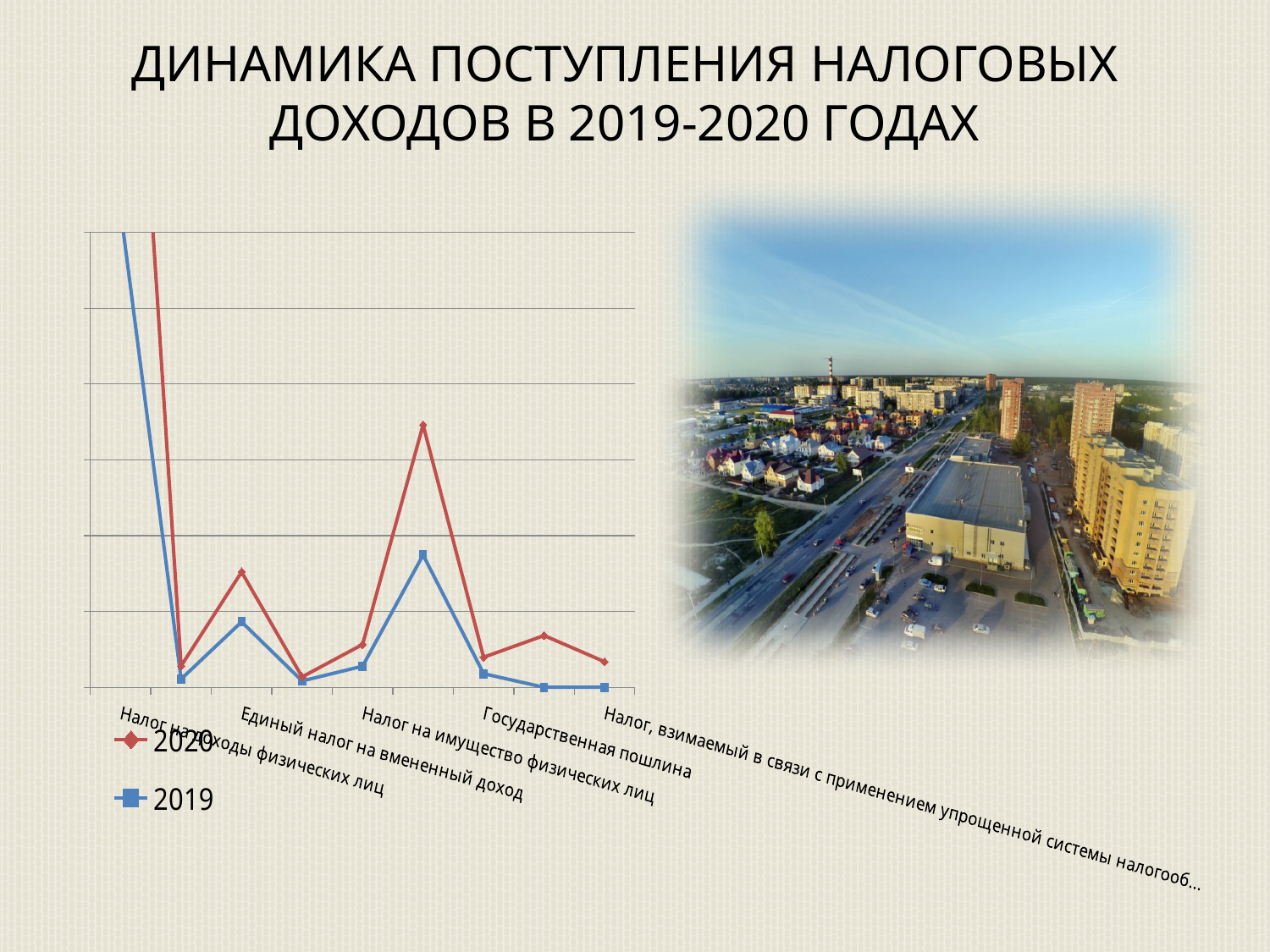
Among the labelled categories, which one has the highest value for the 2020 series? Налог на доходы физических лиц For 'Налог, взимаемый в связи с применением упрощенной системы налогооб...', which series has the higher value, 2020 or 2019? 2020 Does the 2020 line rise or fall from 'Налог на имущество физических лиц' to 'Государственная пошлина'? fall Among the labelled categories, which one has the highest value for the 2019 series? Налог на доходы физических лиц Among the labelled categories, which one has the lowest value for the 2019 series? Налог, взимаемый в связи с применением упрощенной системы налогооб... For 'Налог на имущество физических лиц', which series has the higher value, 2020 or 2019? 2020 For 'Государственная пошлина', which series has the higher value, 2020 or 2019? 2020 What are the two series named in the chart legend? 2020 and 2019 How many series does the chart legend list? 2 Which colour is used for the 2020 series in the chart? red What kind of chart is shown on the slide? line chart